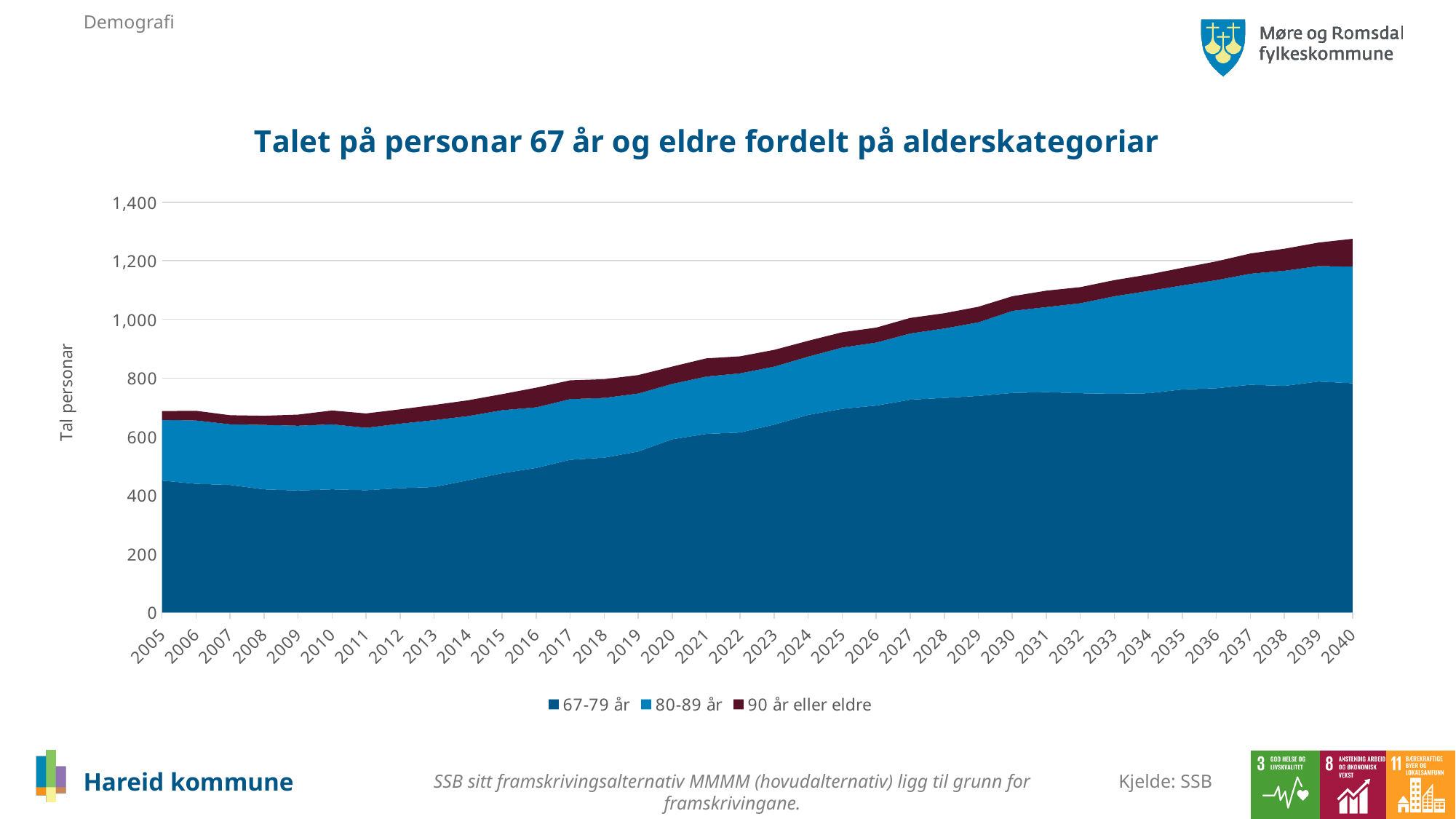
How many years are shown along the x axis? 36 How many series does the legend list? 3 Is the total value for 2040 greater or less than 1,200? greater Is the total value for 2005 greater or less than 800? less Is the total value for 2020 greater or less than 800? greater What is the label on the y axis? Tal personar Does the total number of persons 67 år og eldre rise or fall from 2005 to 2040? rise Which series has the largest value in 2040? 67-79 år What kind of chart is shown on the slide? stacked area chart In 2040, which is larger: the value for 67-79 år or the value for 90 år eller eldre? 67-79 år What is the title of the chart? Talet på personar 67 år og eldre fordelt på alderskategoriar